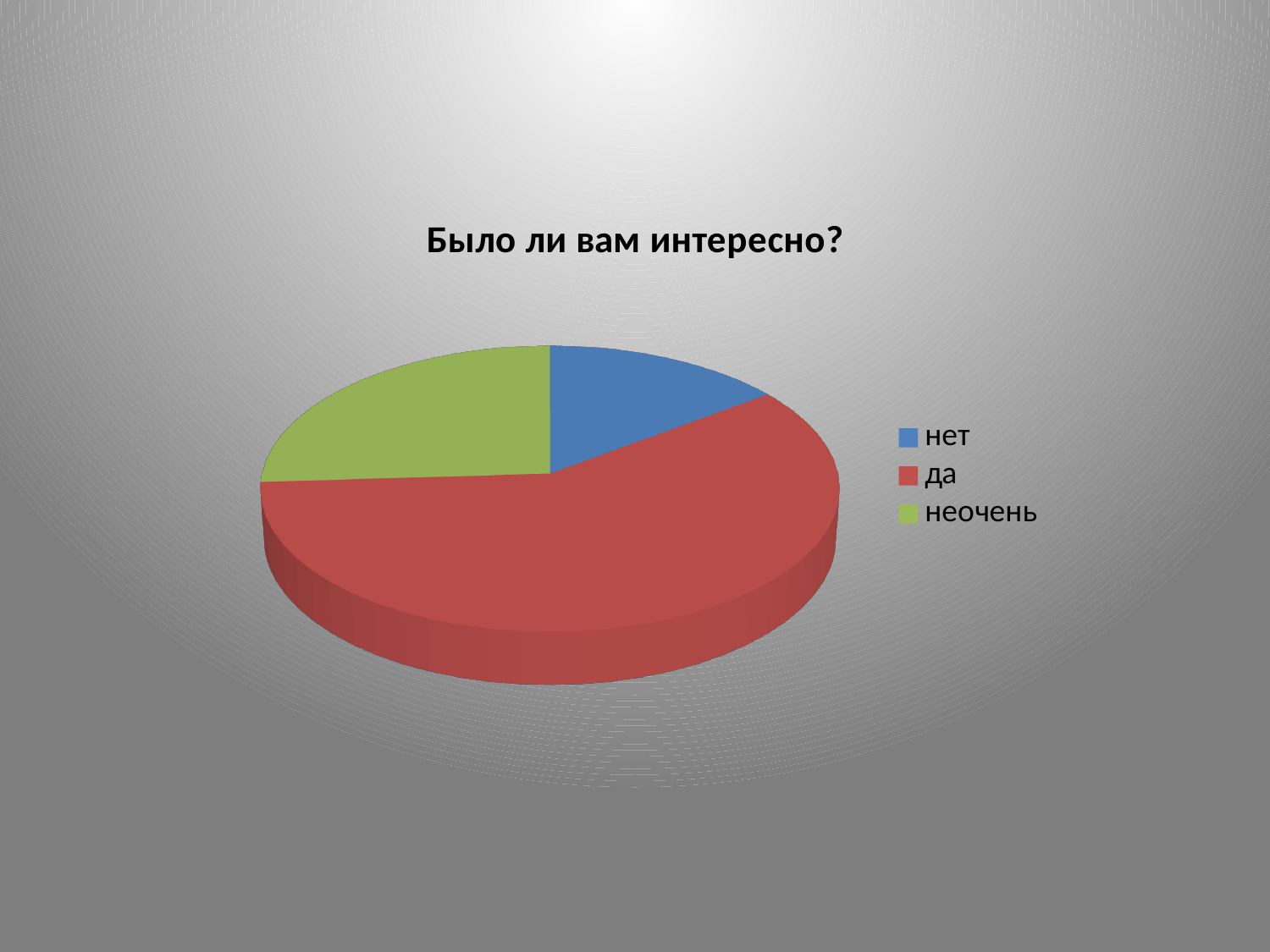
How many slices does the pie chart have? 3 Which slice is larger, "да" or "неочень"? да What kind of chart is shown on the slide? pie chart What colour is the slice for "да"? red Which slice is larger, "да" or "нет"? да Does the "да" slice take up more or less than half of the pie? more How many entries does the legend list? 3 Which category has the smallest slice of the pie? нет What is the title of the chart? Было ли вам интересно? Which category has the largest slice of the pie? да